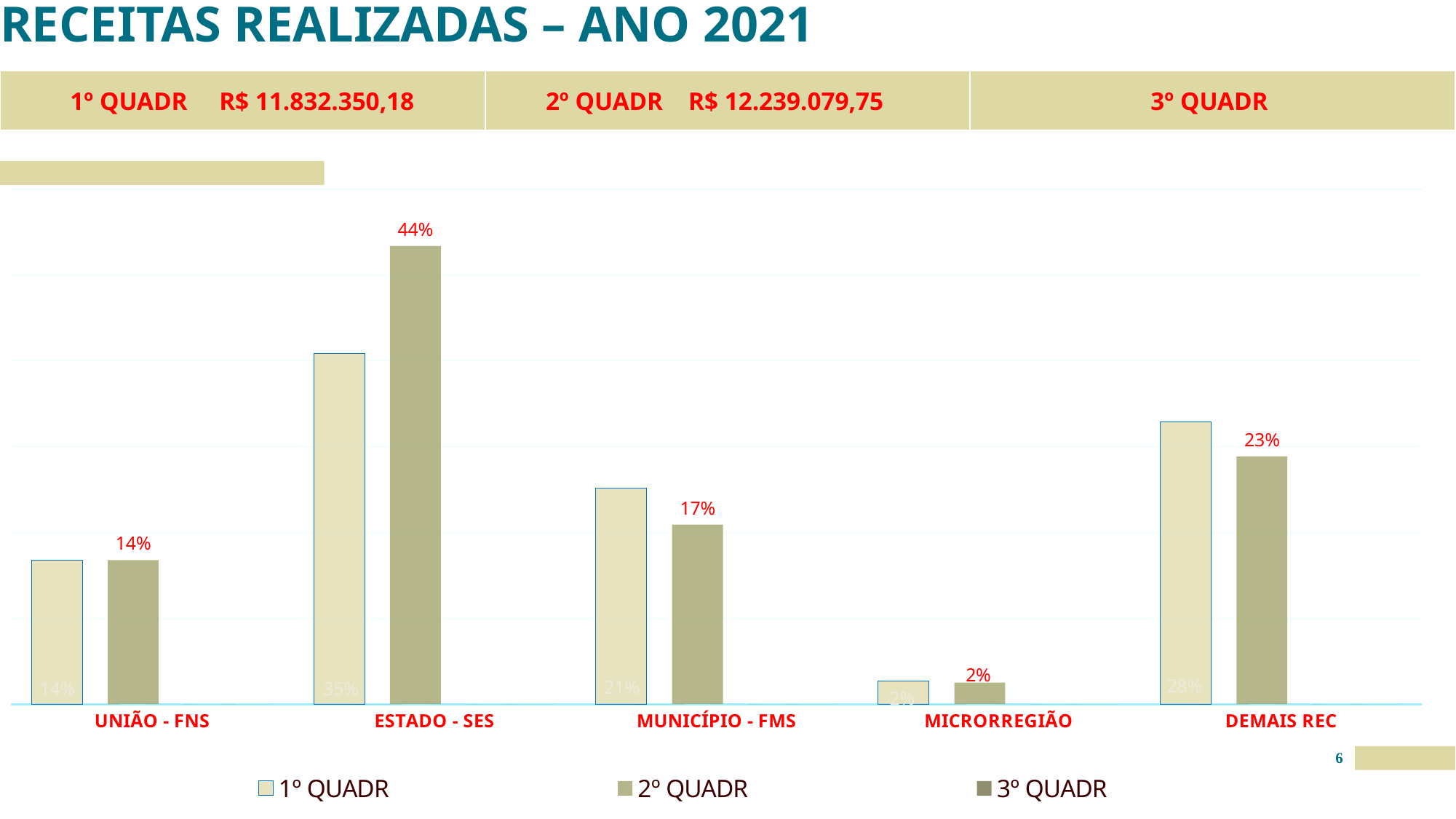
What kind of chart is shown on the slide? bar chart How many categories are shown on the x axis? 5 What is the difference between the 2º QUADR and 1º QUADR values for ESTADO - SES? 9% Which category has the highest 2º QUADR value? ESTADO - SES For MUNICÍPIO - FMS, which is larger: the 1º QUADR value or the 2º QUADR value? 1º QUADR What is the 2º QUADR value for ESTADO - SES? 44% What is the 1º QUADR value for ESTADO - SES? 35% How many series does the legend list? 3 What is the 2º QUADR value for DEMAIS REC? 23% Which category has the lowest 1º QUADR value? MICRORREGIÃO What is the title of the slide? RECEITAS REALIZADAS – ANO 2021 What is the 1º QUADR value for MUNICÍPIO - FMS? 21%